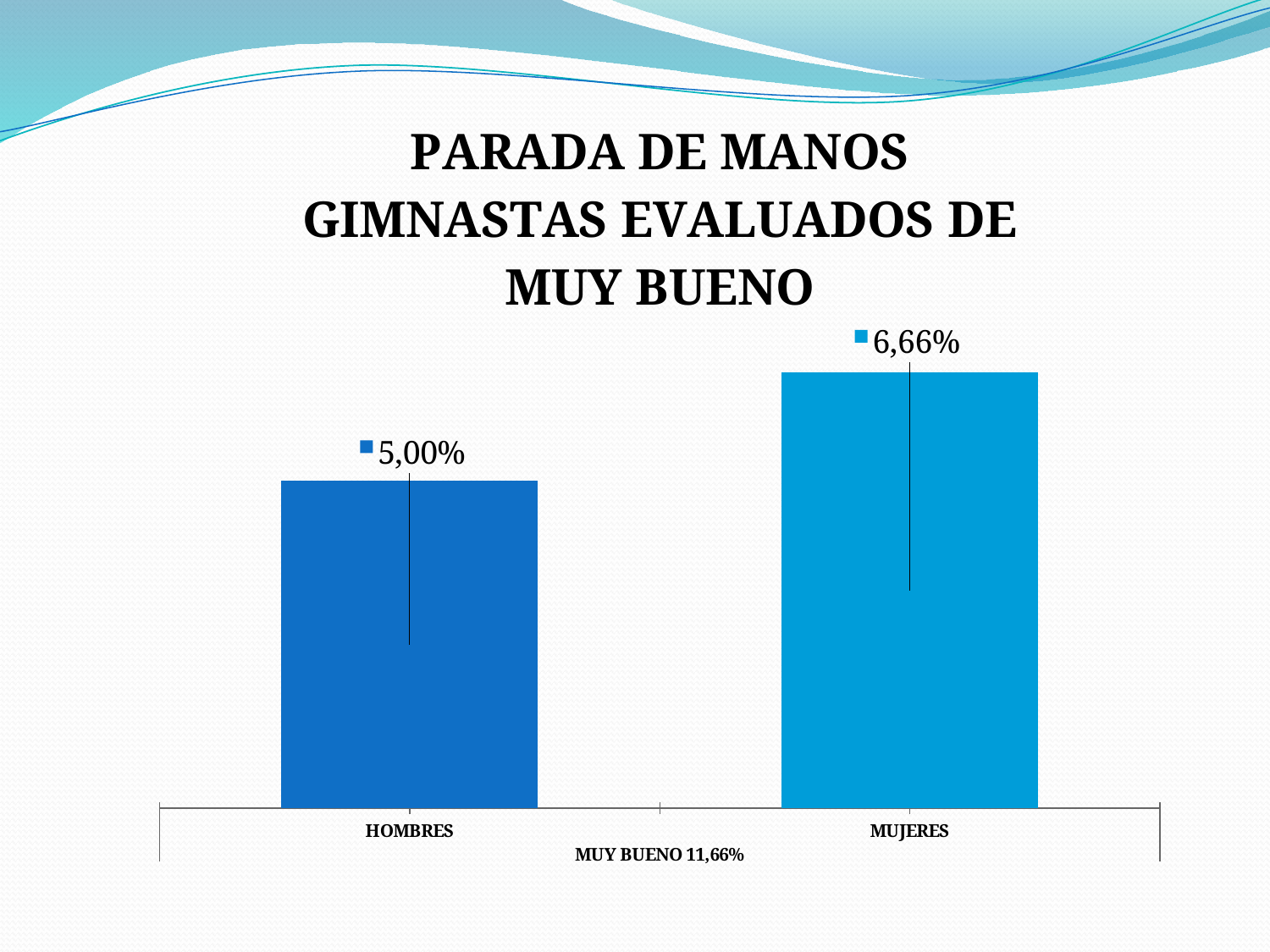
How many categories are shown on the x axis? 2 Which is larger, the value for HOMBRES or the value for MUJERES? MUJERES What kind of chart is shown on the slide? bar chart Which category has the highest value? MUJERES What is the value for HOMBRES? 5,00% What label appears below the category axis? MUY BUENO 11,66% What is the value for MUJERES? 6,66% Which category has the lowest value? HOMBRES What is the difference between the values for MUJERES and HOMBRES? 1,66% What is the title of the chart? PARADA DE MANOS GIMNASTAS EVALUADOS DE MUY BUENO What is the total of the values for HOMBRES and MUJERES? 11,66%